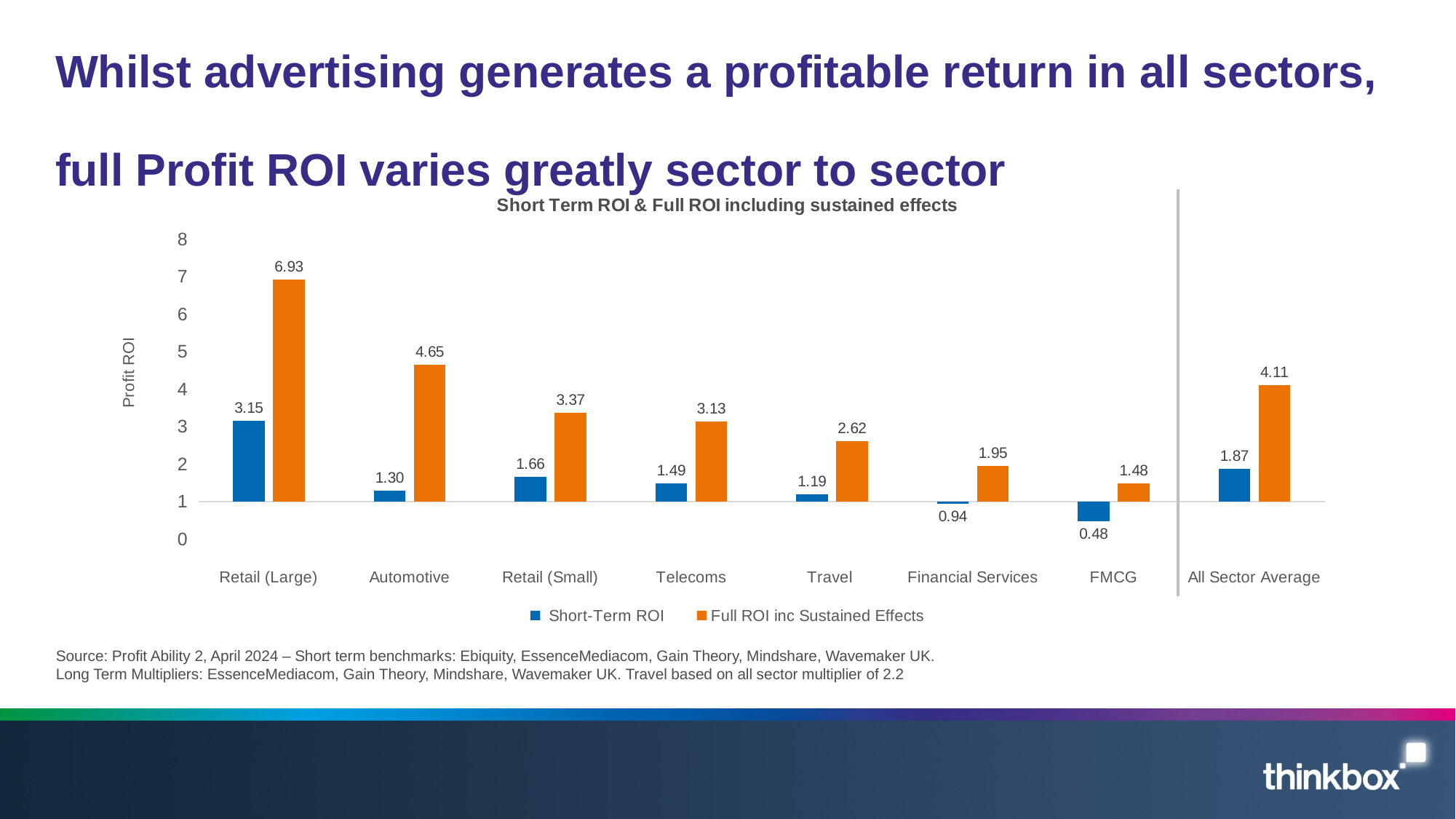
What is the Short-Term ROI value for FMCG? 0.48 Which is larger: the Full ROI inc Sustained Effects for Automotive or for Retail (Small)? Automotive How many series does the legend list? 2 What is the Full ROI inc Sustained Effects value for All Sector Average? 4.11 How many categories are shown on the x axis? 8 What is the difference between the Full ROI inc Sustained Effects and the Short-Term ROI for Telecoms? 1.64 What is the Short-Term ROI value for Automotive? 1.30 What is the title of the chart? Short Term ROI & Full ROI including sustained effects Which sector has the lowest Short-Term ROI? FMCG What is the Full ROI inc Sustained Effects value for Retail (Large)? 6.93 Which sector has the highest Full ROI inc Sustained Effects? Retail (Large) What kind of chart is shown on the slide? Bar chart